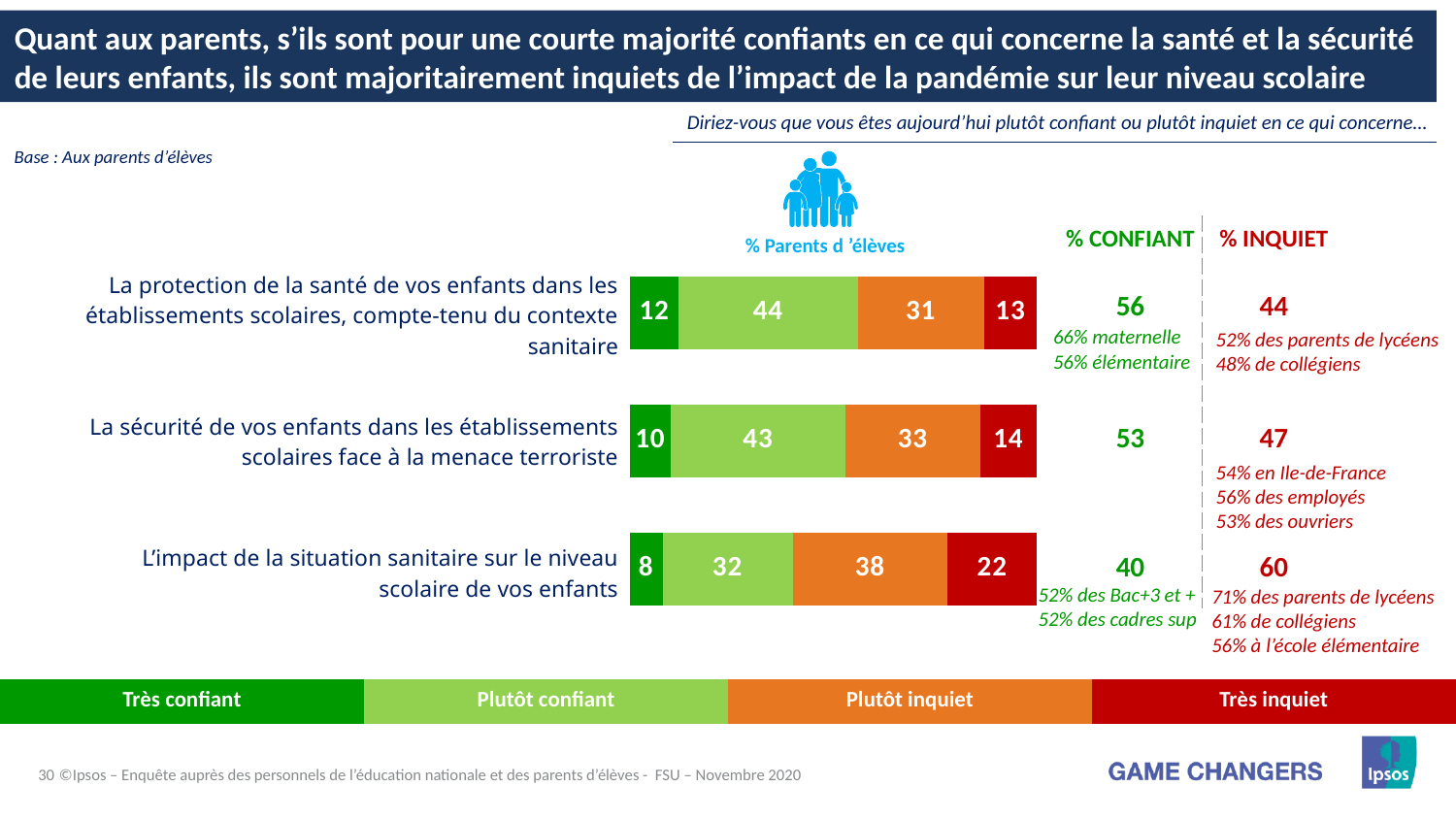
What is the 'Plutôt inquiet' value for 'La sécurité de vos enfants dans les établissements scolaires face à la menace terroriste'? 33 Which item has the lowest 'Plutôt confiant' value? L'impact de la situation sanitaire sur le niveau scolaire de vos enfants What is the 'Plutôt confiant' value for 'La protection de la santé de vos enfants dans les établissements scolaires, compte-tenu du contexte sanitaire'? 44 How many series does the legend list? 4 What kind of chart is shown on the slide? Stacked bar chart What is the total of the stacked bar for 'La sécurité de vos enfants dans les établissements scolaires face à la menace terroriste'? 100 What is the '% INQUIET' figure shown for 'L'impact de la situation sanitaire sur le niveau scolaire de vos enfants'? 60 What is the 'Très inquiet' value for 'L'impact de la situation sanitaire sur le niveau scolaire de vos enfants'? 22 Which is larger: the 'Plutôt inquiet' value for 'L'impact de la situation sanitaire sur le niveau scolaire de vos enfants' or for 'La sécurité de vos enfants dans les établissements scolaires face à la menace terroriste'? L'impact de la situation sanitaire sur le niveau scolaire de vos enfants What is the difference between the 'Très inquiet' values for 'L'impact de la situation sanitaire sur le niveau scolaire de vos enfants' and 'La protection de la santé de vos enfants dans les établissements scolaires'? 9 How many categories (items) are plotted in the chart? 3 Which item has the highest 'Très confiant' value? La protection de la santé de vos enfants dans les établissements scolaires, compte-tenu du contexte sanitaire